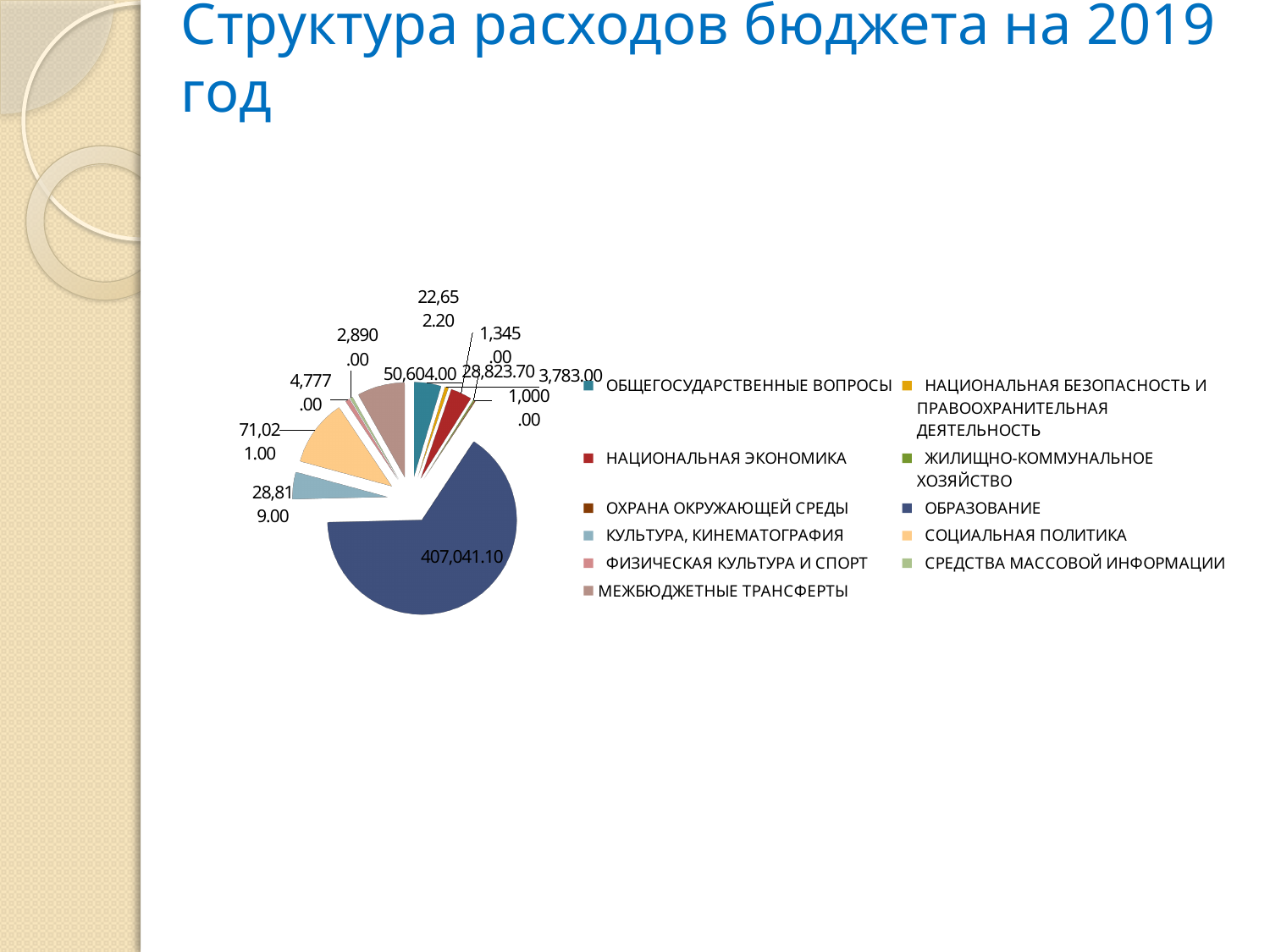
What kind of chart is shown on the slide? pie chart Which is larger, the slice for ОБРАЗОВАНИЕ or the slice for МЕЖБЮДЖЕТНЫЕ ТРАНСФЕРТЫ? ОБРАЗОВАНИЕ What is the value shown for НАЦИОНАЛЬНАЯ ЭКОНОМИКА? 22,652.20 What is the value shown for ОБРАЗОВАНИЕ? 407,041.10 What colour is the slice for ОБРАЗОВАНИЕ? dark blue What is the title of the slide's chart? Структура расходов бюджета на 2019 год What is the value shown for СОЦИАЛЬНАЯ ПОЛИТИКА? 71,021.00 Which is larger, the slice for СОЦИАЛЬНАЯ ПОЛИТИКА or the slice for ОБЩЕГОСУДАРСТВЕННЫЕ ВОПРОСЫ? СОЦИАЛЬНАЯ ПОЛИТИКА How many categories does the legend of the pie chart list? 11 What is the difference between the values for ОБРАЗОВАНИЕ and СОЦИАЛЬНАЯ ПОЛИТИКА? 336,020.10 Which category has the largest slice of the pie chart? ОБРАЗОВАНИЕ What is the value shown for ОБЩЕГОСУДАРСТВЕННЫЕ ВОПРОСЫ? 28,823.70